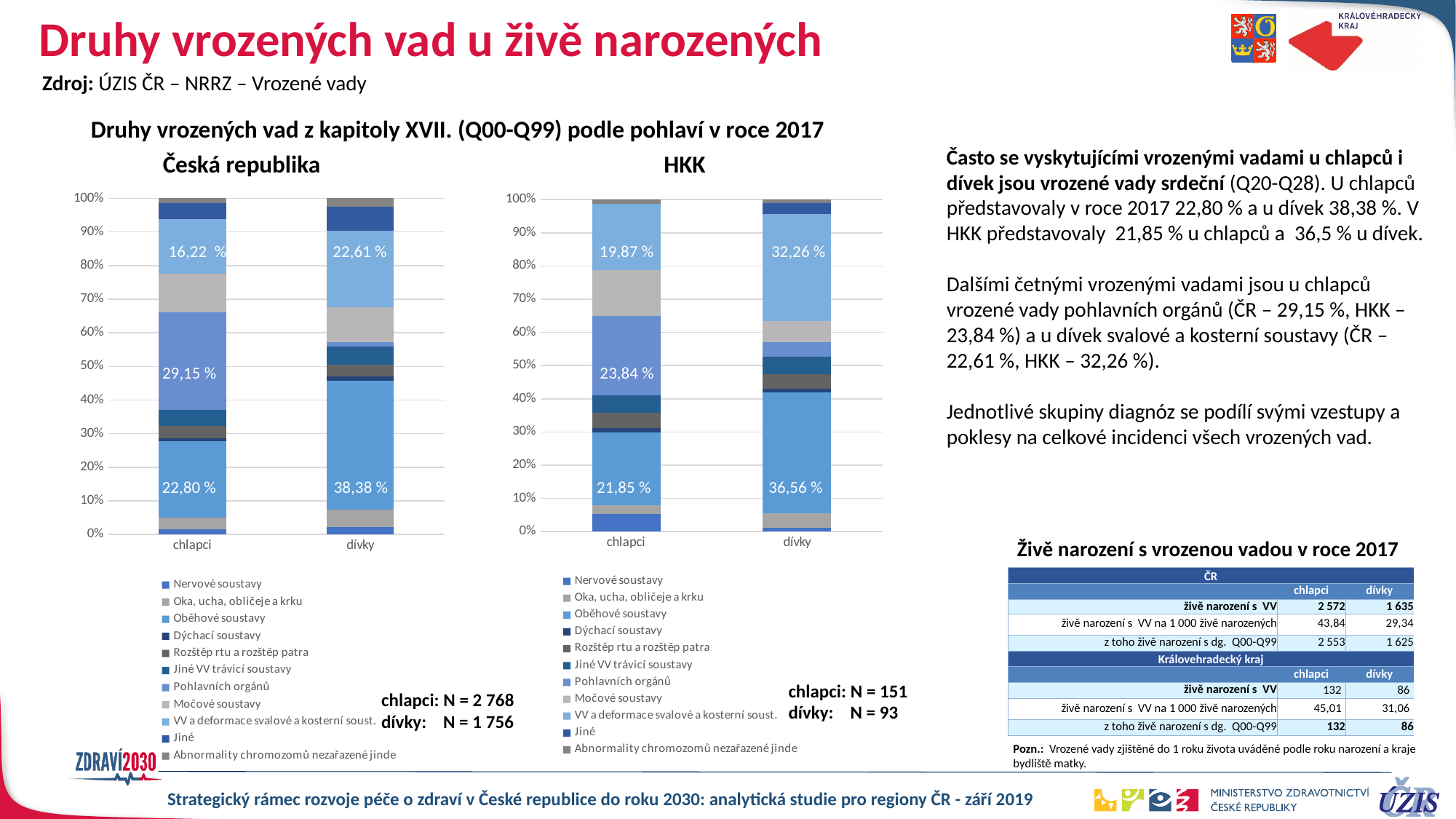
In the Česká republika chart, what is the labelled share of Oběhové soustavy for chlapci? 22,80 % In the HKK chart, what is the labelled share of VV a deformace svalové a kosterní soust. for dívky? 32,26 % How many series does the legend of the HKK chart list? 11 In the Česká republika chart, what is the difference between the Oběhové soustavy shares for dívky and chlapci? 15,58 % In the HKK chart, which is larger: the Oběhové soustavy share for chlapci or for dívky? dívky In the Česká republika chart, what is the labelled share of Pohlavních orgánů for chlapci? 29,15 % In the HKK chart, what is the labelled share of Pohlavních orgánů for chlapci? 23,84 % What type of chart is the HKK chart? stacked bar chart How many categories are shown on the x axis of the Česká republika chart? 2 In the Česká republika chart, is the VV a deformace svalové a kosterní soust. share for dívky greater or less than the same share for chlapci? greater In the HKK chart, what is the labelled share of Oběhové soustavy for chlapci? 21,85 % In the Česká republika chart, what is the labelled share of Oběhové soustavy for dívky? 38,38 %